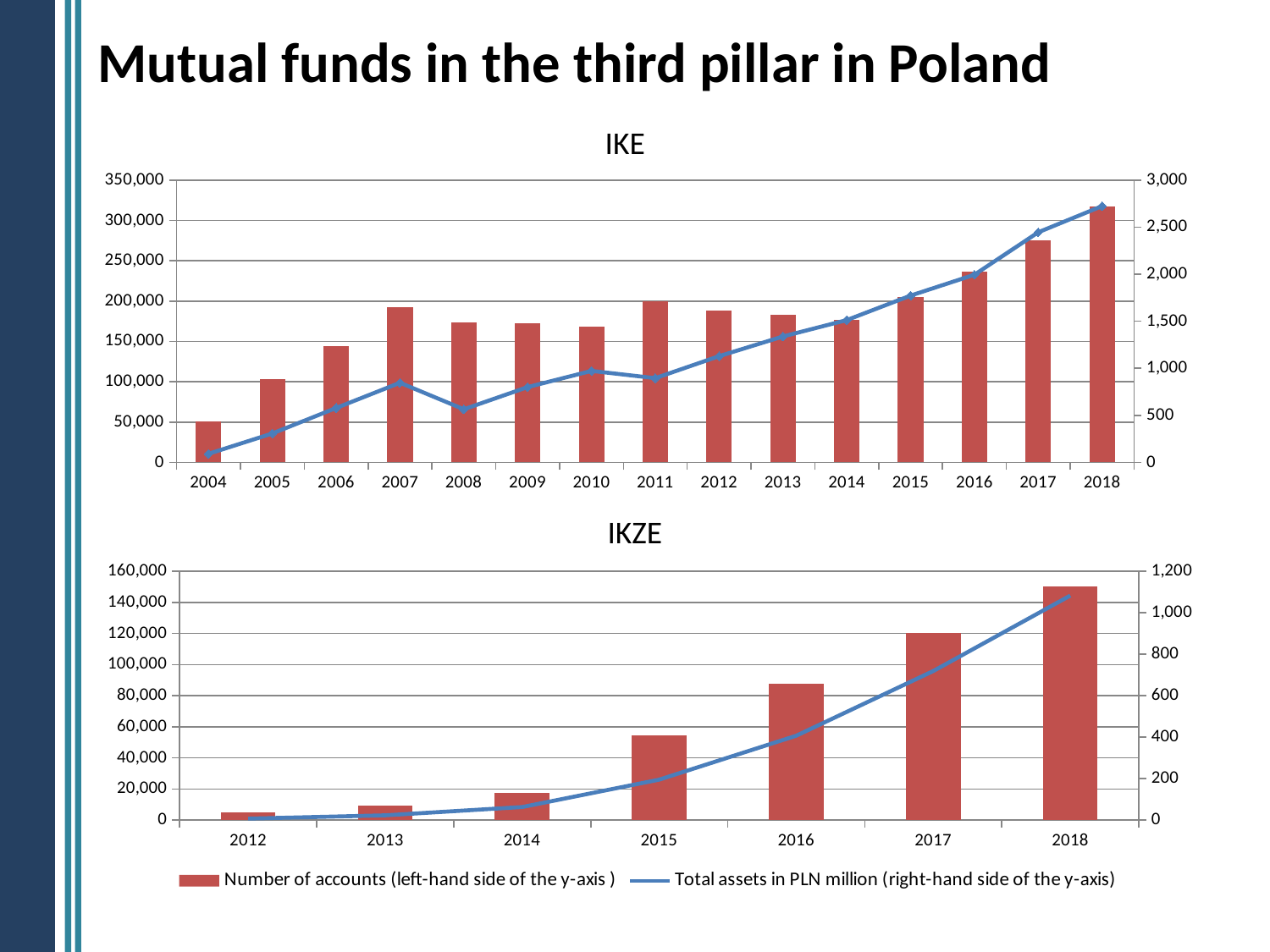
In the IKE chart, which year has the highest number of accounts? 2018 In the IKZE chart, do the number of accounts rise or fall from 2012 to 2018? rise What type of chart is the IKE chart? Combined bar and line chart In the IKZE chart, which year has the highest number of accounts? 2018 In the IKZE chart, which is larger, the number of accounts in 2015 or in 2016? 2016 In the IKE chart, which year has the lowest number of accounts? 2004 How many years are shown on the x axis of the IKZE chart? 7 In the IKZE chart, is the number of accounts in 2016 greater or less than 80,000? greater In the IKE chart, is the total assets value in 2008 greater or less than 1,000? less How many series does the legend list? 2 In the IKE chart, is the number of accounts in 2018 greater or less than 300,000? greater How many years are shown on the x axis of the IKE chart? 15